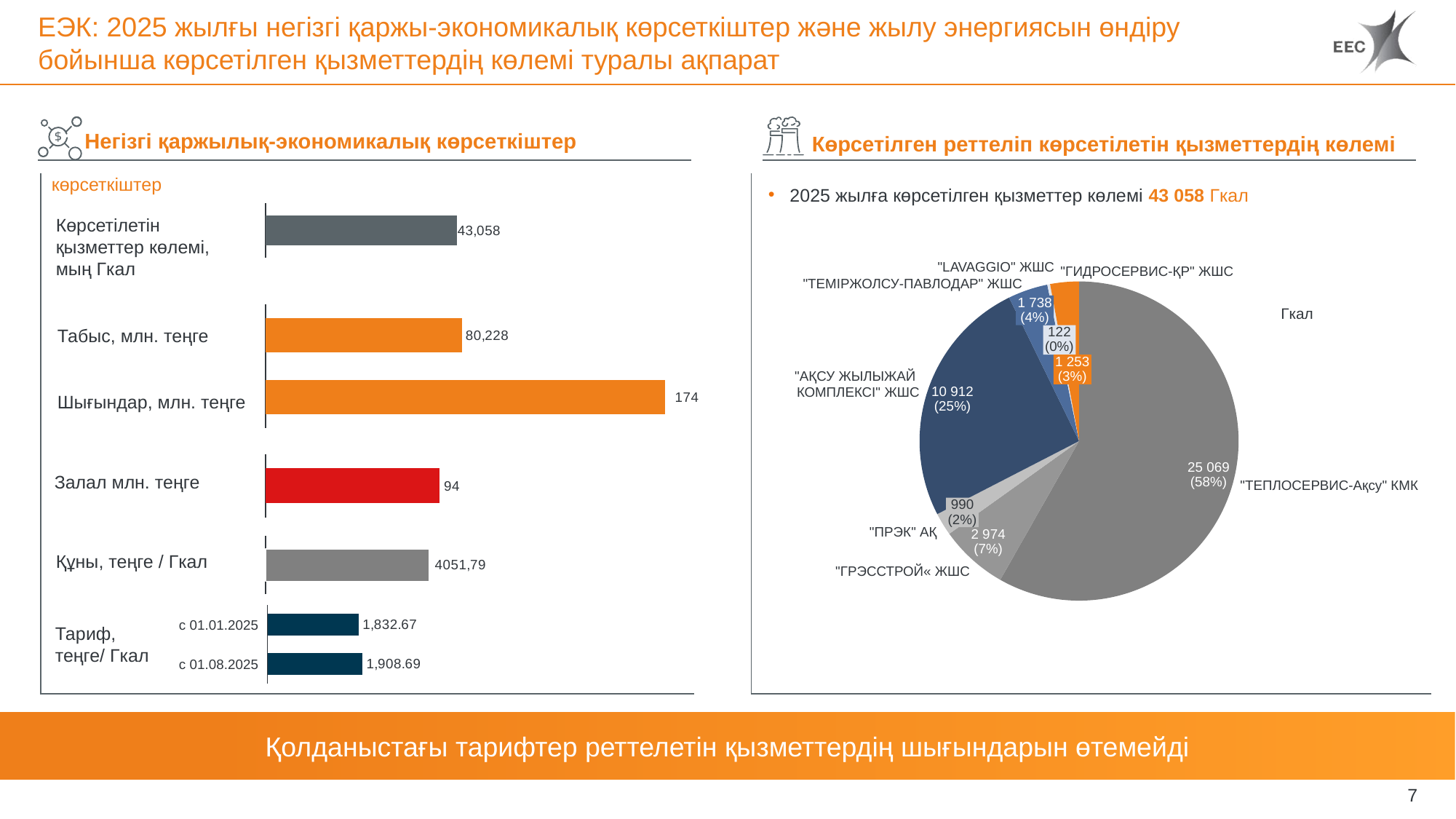
What kind of chart is the right chart titled "Көрсетілген реттеліп көрсетілетін қызметтердің көлемі"? pie chart In the right pie chart, how many slices are there? 7 What kind of chart is the left chart titled "Негізгі қаржылық-экономикалық көрсеткіштер"? bar chart In the left bar chart, what is the value for "Залал млн. теңге"? 94 In the left bar chart, what is the value for "Табыс, млн. теңге"? 80,228 In the left bar chart, what is the difference between the tariff from 01.08.2025 (1,908.69) and the tariff from 01.01.2025 (1,832.67)? 76.02 In the left bar chart, what is the tariff value for "с 01.08.2025"? 1,908.69 In the right pie chart, what is the value (Гкал) for "ГРЭССТРОЙ« ЖШС? 2 974 In the right pie chart, what share does "АҚСУ ЖЫЛЫЖАЙ КОМПЛЕКСІ" ЖШС have? 25% In the left bar chart, what is the value for "Құны, теңге / Гкал"? 4051,79 In the right pie chart, which company has the largest slice? "ТЕПЛОСЕРВИС-Ақсу" КМК In the right pie chart, which company has the smallest slice? "LAVAGGIO" ЖШС